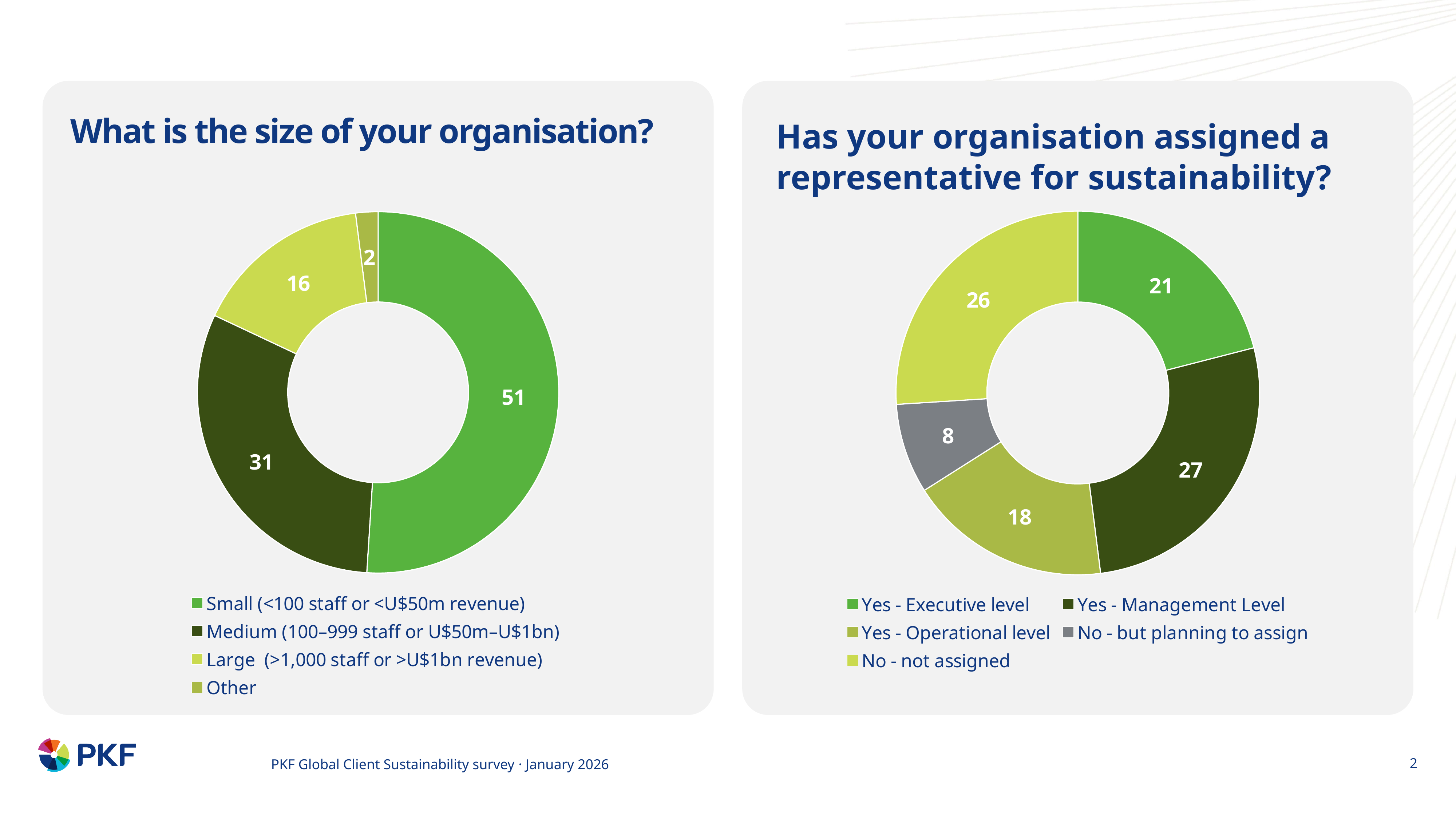
What kind of chart is used on the right-hand side of the slide? Doughnut (pie) chart In the chart titled "What is the size of your organisation?", what is the value for Small (<100 staff or <U$50m revenue)? 51 In the chart titled "Has your organisation assigned a representative for sustainability?", which is larger: Yes - Executive level or No - not assigned? No - not assigned In the chart titled "Has your organisation assigned a representative for sustainability?", what is the difference between Yes - Operational level and No - but planning to assign? 10 In the chart titled "What is the size of your organisation?", what share of the total do the Medium (100–999 staff or U$50m–U$1bn) organisations represent? 31% In the chart titled "Has your organisation assigned a representative for sustainability?", what is the value for Yes - Management Level? 27 In the chart titled "What is the size of your organisation?", what is the value for Large (>1,000 staff or >U$1bn revenue)? 16 In the chart titled "What is the size of your organisation?", what is the difference between the Small and Medium values? 20 In the chart titled "What is the size of your organisation?", which category has the smallest slice? Other In the chart titled "Has your organisation assigned a representative for sustainability?", what is the value for No - but planning to assign? 8 In the chart titled "Has your organisation assigned a representative for sustainability?", which category has the largest value? Yes - Management Level In the chart titled "What is the size of your organisation?", how many categories does the legend list? 4